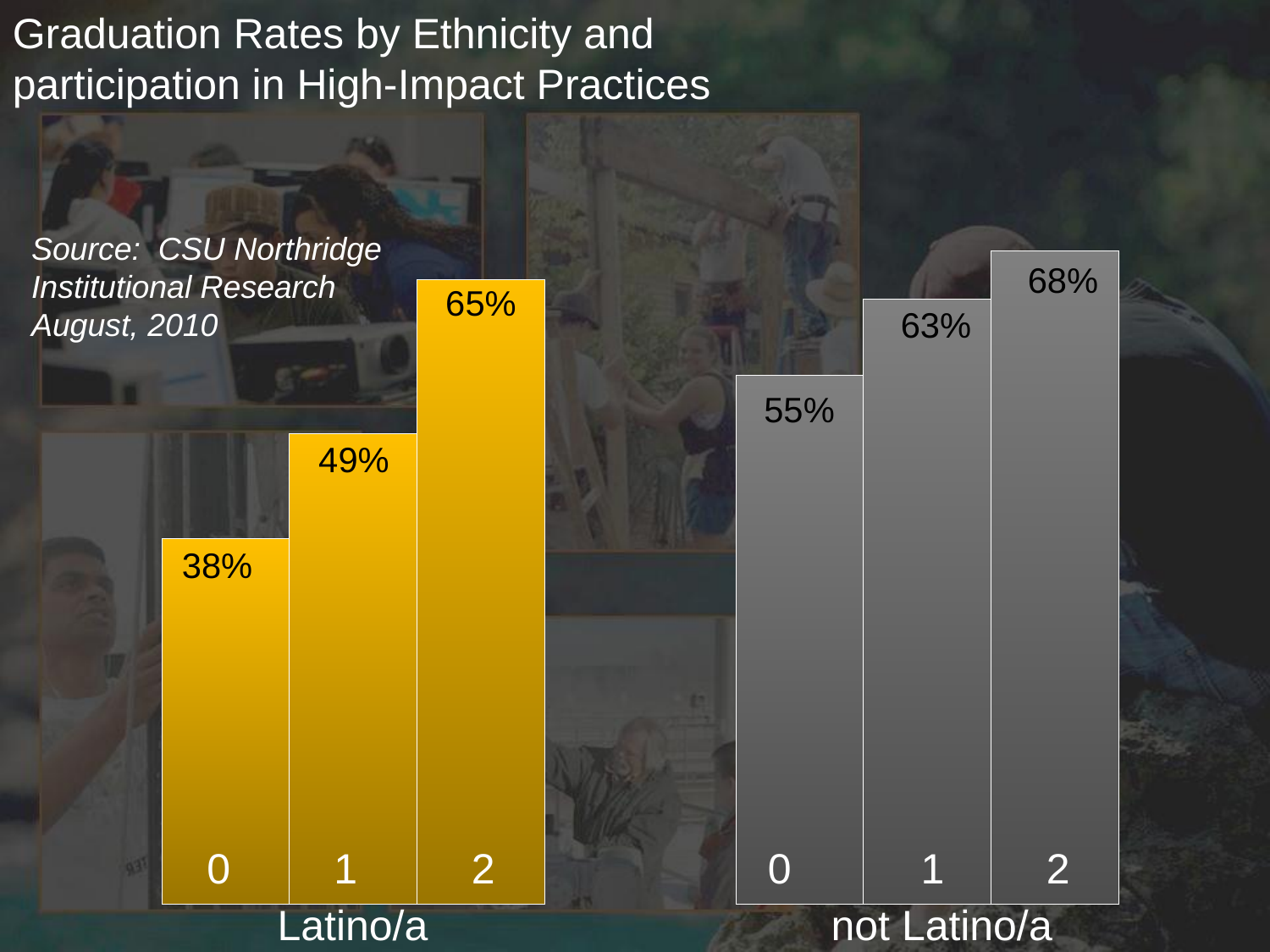
Which is larger: the graduation rate for Latino/a students with 2 practices or not Latino/a students with 1 practice? Latino/a students with 2 practices Which bar shows the lowest graduation rate on the chart? Latino/a, 0 What is the graduation rate for Latino/a students with 0 high-impact practices? 38% What is the graduation rate for not Latino/a students with 2 high-impact practices? 68% What is the graduation rate for not Latino/a students with 0 high-impact practices? 55% What is the difference between the graduation rates for Latino/a students with 2 and with 0 high-impact practices? 27% What is the graduation rate for Latino/a students with 1 high-impact practice? 49% How many bars are shown on the chart in total? 6 Which bar shows the highest graduation rate on the chart? not Latino/a, 2 What is the difference between the graduation rates for not Latino/a and Latino/a students with 1 high-impact practice? 14% What kind of chart is shown on the slide? Bar chart Do graduation rates rise or fall as the number of high-impact practices increases from 0 to 2 for each group? Rise